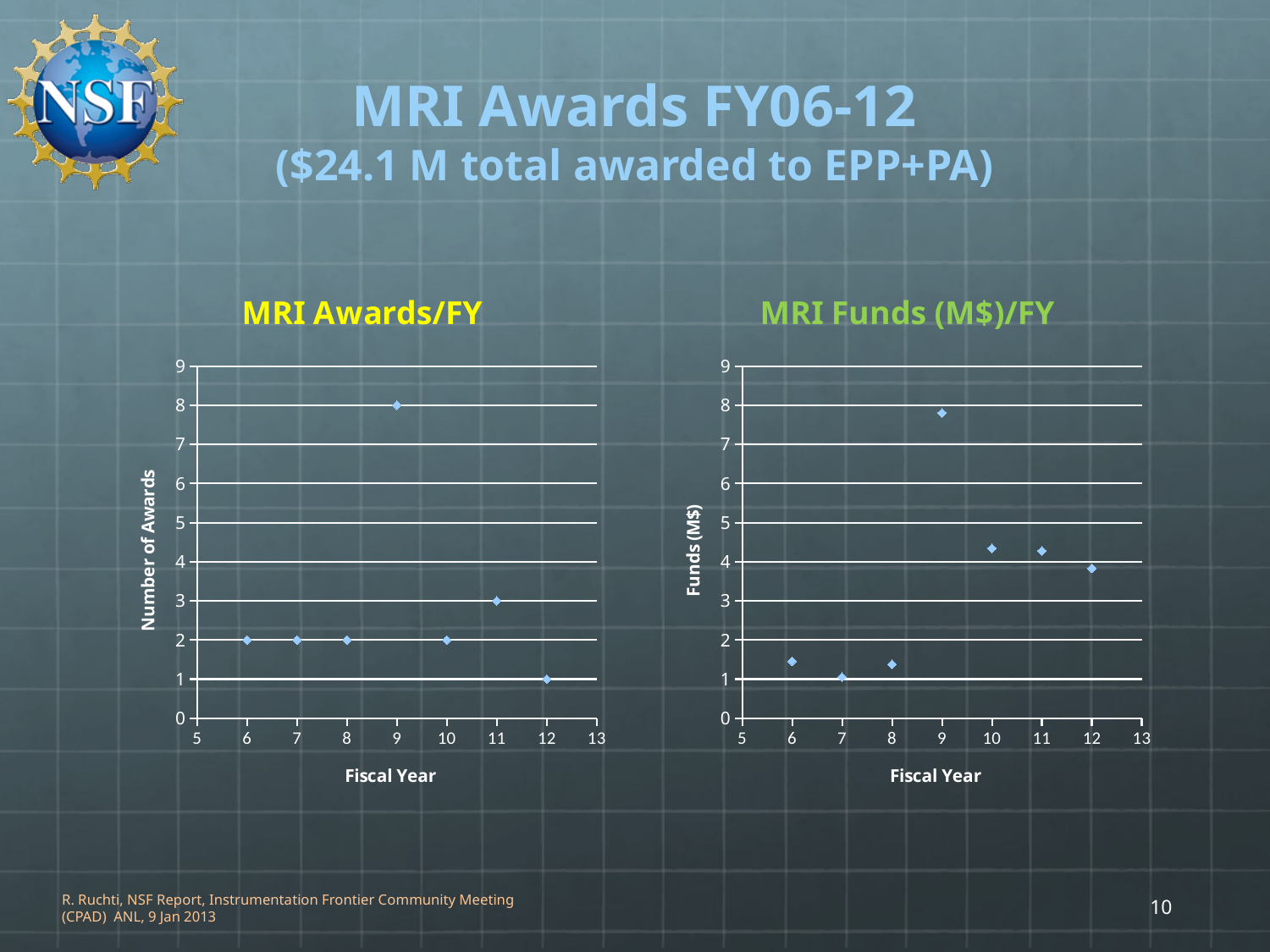
In the MRI Funds (M$)/FY chart, is the value for fiscal year 12 greater or less than 4? less What kind of chart is the MRI Funds (M$)/FY chart? scatter chart In the MRI Funds (M$)/FY chart, which fiscal year has the lowest funds? 7 In the MRI Awards/FY chart, what is the difference between the number of awards in fiscal year 9 and fiscal year 10? 6 In the MRI Awards/FY chart, which fiscal year has the highest number of awards? 9 In the MRI Awards/FY chart, what is the number of awards for fiscal year 11? 3 In the MRI Funds (M$)/FY chart, which fiscal year has the highest funds? 9 In the MRI Awards/FY chart, which fiscal year has the lowest number of awards? 12 In the MRI Awards/FY chart, what is the number of awards for fiscal year 12? 1 In the MRI Awards/FY chart, what is the number of awards for fiscal year 9? 8 In the MRI Awards/FY chart, how many fiscal years have data points plotted? 7 In the MRI Funds (M$)/FY chart, is the value for fiscal year 9 greater or less than 7? greater